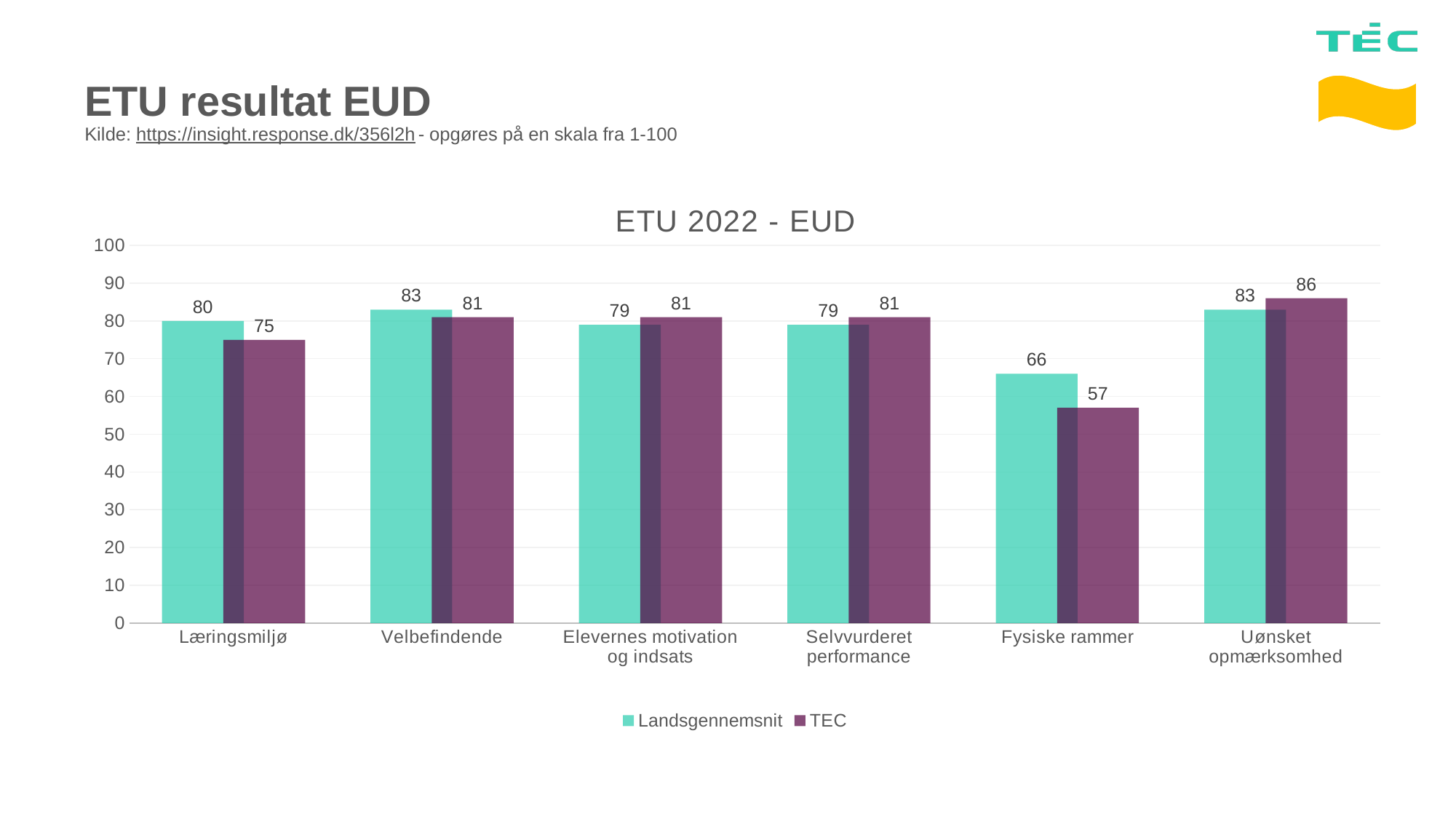
How many categories are shown on the x axis? 6 What is the TEC value for Fysiske rammer? 57 Which category has the highest TEC value? Uønsket opmærksomhed Which is larger for Læringsmiljø, the Landsgennemsnit value or the TEC value? Landsgennemsnit How many series does the legend list? 2 What is the difference between the Landsgennemsnit and TEC values for Fysiske rammer? 9 What is the TEC value for Uønsket opmærksomhed? 86 Is the TEC value for Fysiske rammer greater or less than 60? less What is the Landsgennemsnit value for Læringsmiljø? 80 What is the title of the chart? ETU 2022 - EUD Which category has the lowest Landsgennemsnit value? Fysiske rammer What kind of chart is shown on the slide? bar chart